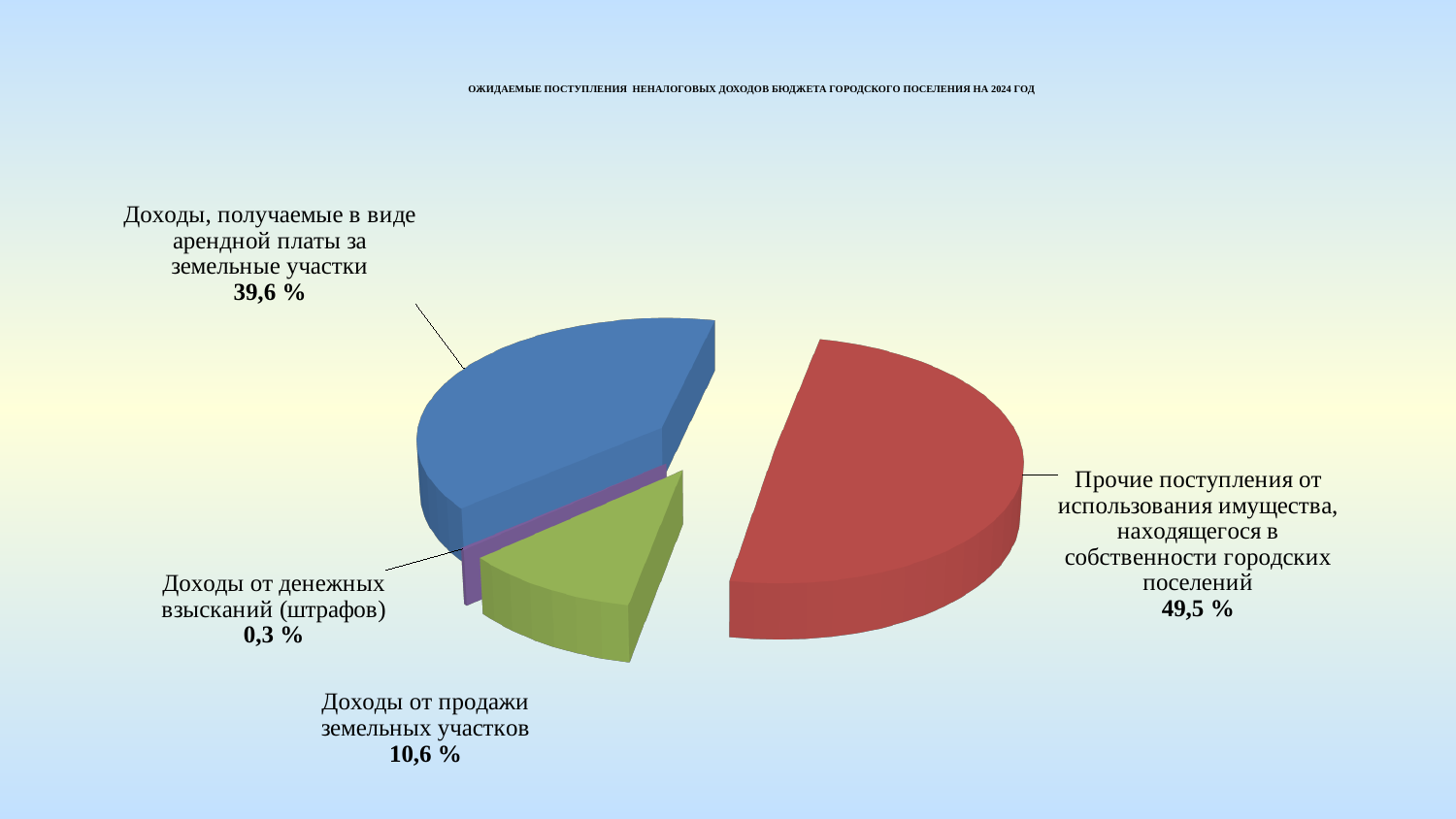
What is the difference in percentage points between the slice for 'Прочие поступления от использования имущества' and the slice for 'Доходы, получаемые в виде арендной платы за земельные участки'? 9,9 % Which category has the smallest slice of the pie? Доходы от денежных взысканий (штрафов) What share of the pie is labelled for 'Прочие поступления от использования имущества, находящегося в собственности городских поселений'? 49,5 % What kind of chart is shown on the slide? Pie chart Which is larger: the slice for 'Доходы, получаемые в виде арендной платы за земельные участки' or the slice for 'Доходы от продажи земельных участков'? Доходы, получаемые в виде арендной платы за земельные участки What share of the pie is labelled for 'Доходы, получаемые в виде арендной платы за земельные участки'? 39,6 % How many slices does the pie chart have? 4 What share of the pie is labelled for 'Доходы от продажи земельных участков'? 10,6 % Which category has the largest slice of the pie? Прочие поступления от использования имущества, находящегося в собственности городских поселений What colour is the slice for 'Доходы от продажи земельных участков'? Green What is the difference in percentage points between 'Доходы от продажи земельных участков' and 'Доходы от денежных взысканий (штрафов)'? 10,3 %